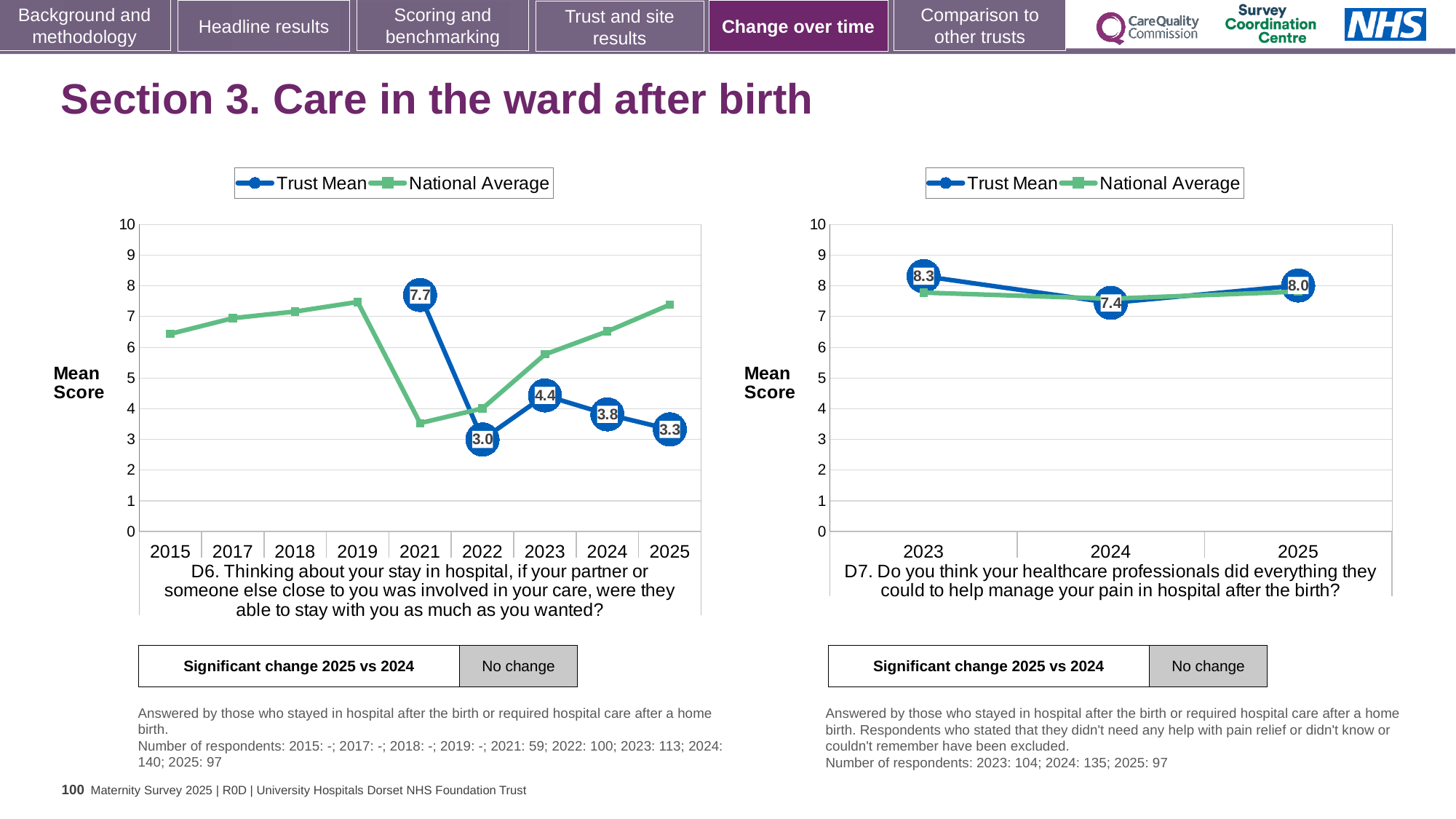
In the D6 chart on the left, what is the Trust Mean for 2021? 7.7 In the D7 chart on the right, what is the Trust Mean for 2024? 7.4 In the D6 chart on the left, what is the Trust Mean for 2025? 3.3 In the D6 chart on the left, what is the difference between the Trust Mean in 2021 and 2022? 4.7 In the D6 chart on the left, is the National Average for 2019 greater or less than 7? greater In the D6 chart on the left, which year has the lowest Trust Mean? 2022 In the D6 chart on the left, which year has the highest Trust Mean? 2021 In the D7 chart on the right, which year has the highest Trust Mean? 2023 In the D6 chart on the left, how many years are shown on the x axis? 9 In the D7 chart on the right, what is the difference between the Trust Mean in 2023 and 2025? 0.3 How many series does the legend of the D7 chart on the right list? 2 In the D7 chart on the right, is the Trust Mean for 2023 larger or smaller than the Trust Mean for 2024? larger